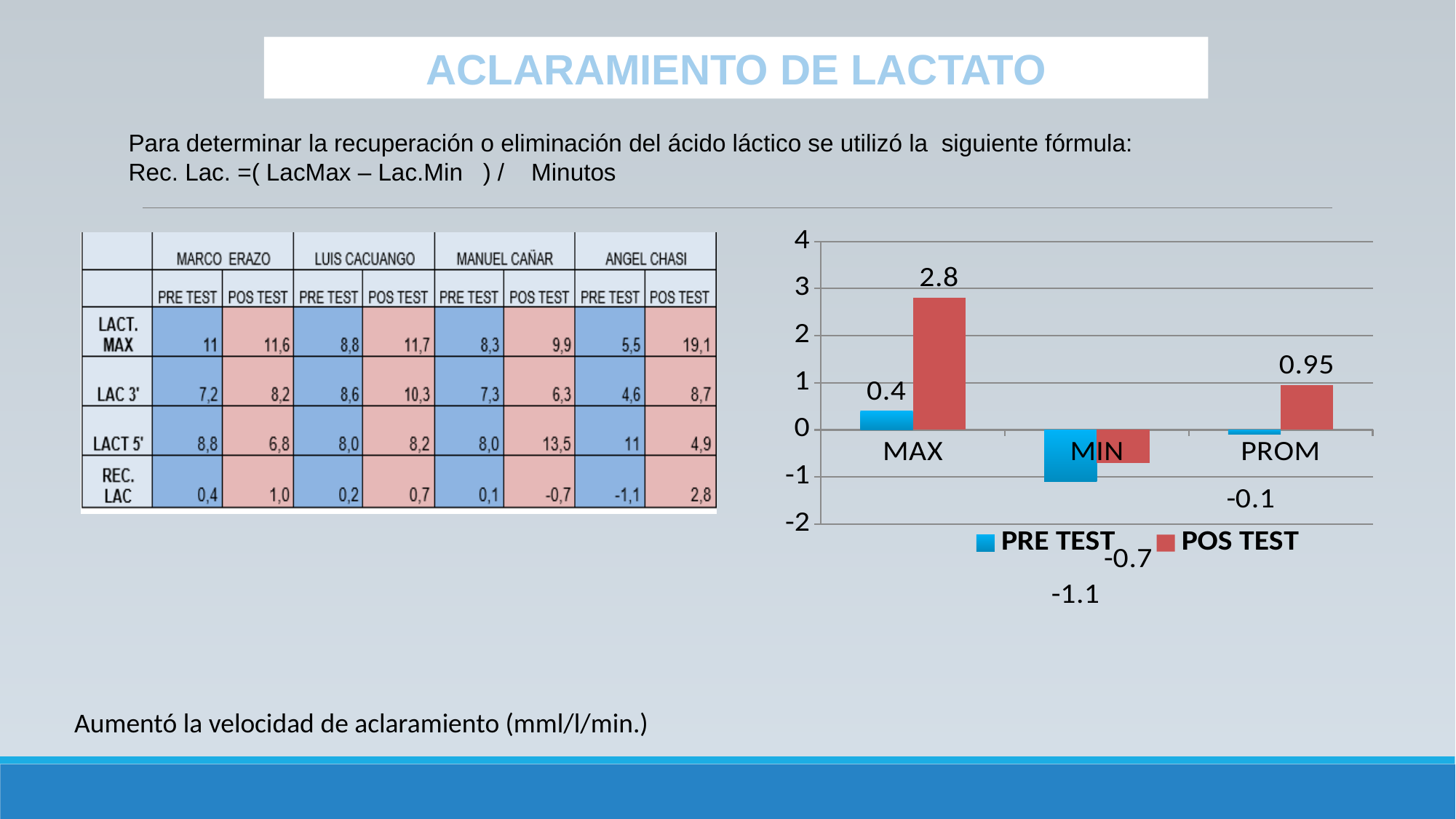
How many categories are shown on the x axis of the chart? 3 What is the PRE TEST value for PROM in the chart? -0.1 What is the PRE TEST value for MIN in the chart? -1.1 What kind of chart is shown on the slide? Bar chart Which category has the lowest PRE TEST value in the chart? MIN What is the difference between the POS TEST and PRE TEST values for MAX in the chart? 2.4 What is the POS TEST value for PROM in the chart? 0.95 What colour are the POS TEST bars in the chart? Red How many series does the chart legend list? 2 Which is larger for MIN in the chart, the PRE TEST value or the POS TEST value? POS TEST What is the POS TEST value for MAX in the chart? 2.8 Which category has the highest POS TEST value in the chart? MAX